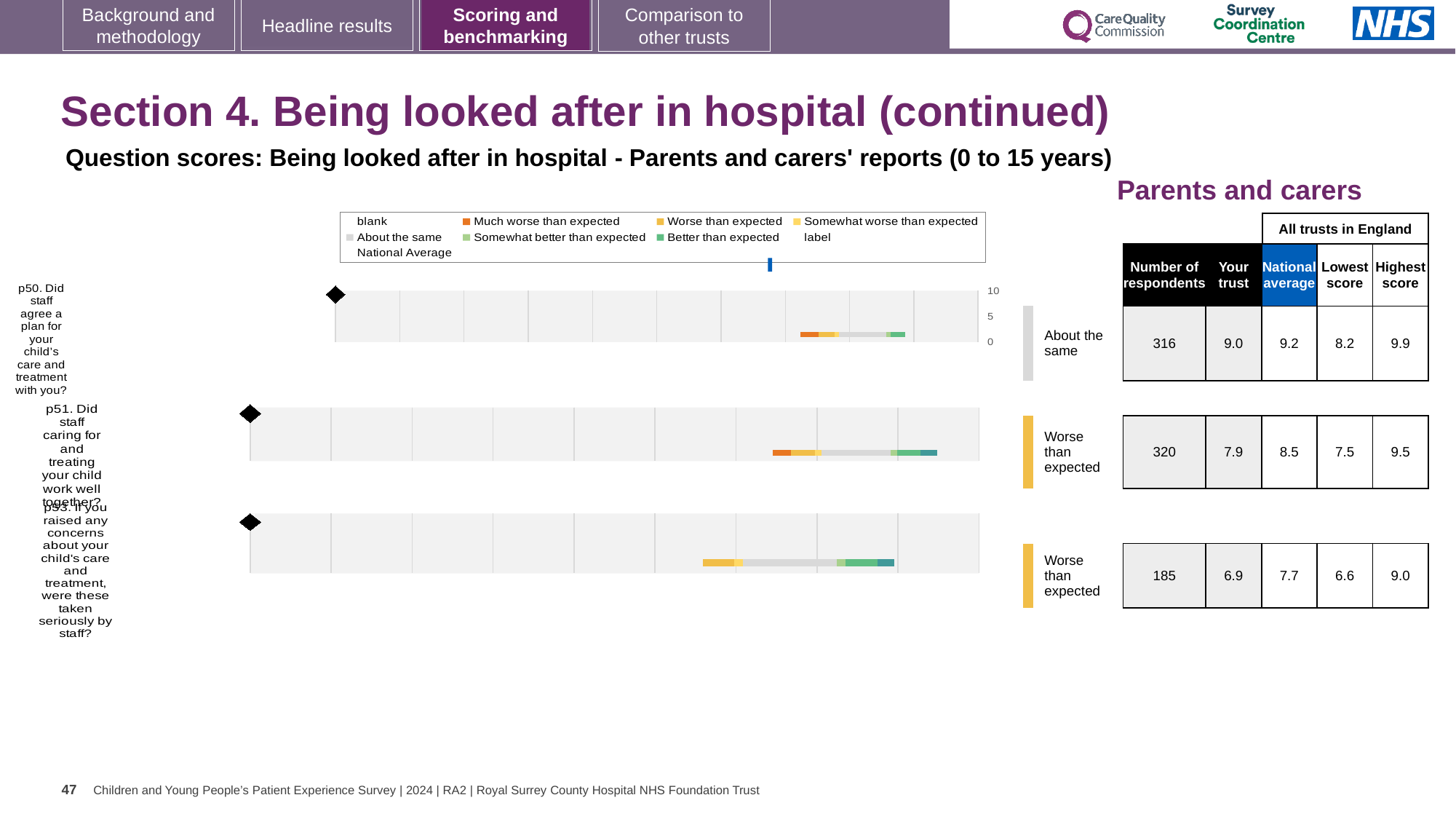
What is the 'Your trust' score for question p51 (Did staff caring for and treating your child work well together?)? 7.9 What is the lowest score among all trusts in England for question p53? 6.6 Which question has the lowest number of respondents on this slide? p53 What benchmark category is shown for question p50? About the same For question p50, which is larger: the 'Your trust' score or the national average? National average How many survey questions are charted on this slide? 3 For question p51, what is the difference between the national average and the 'Your trust' score? 0.6 For question p51, what is the difference between the highest score and the lowest score among all trusts in England? 2.0 What is the national average score for question p53 (If you raised any concerns about your child's care and treatment, were these taken seriously by staff?)? 7.7 What is the highest score among all trusts in England for question p50? 9.9 Which question has the highest 'Your trust' score on this slide? p50 How many respondents are shown for question p50 (Did staff agree a plan for your child's care and treatment with you?)? 316